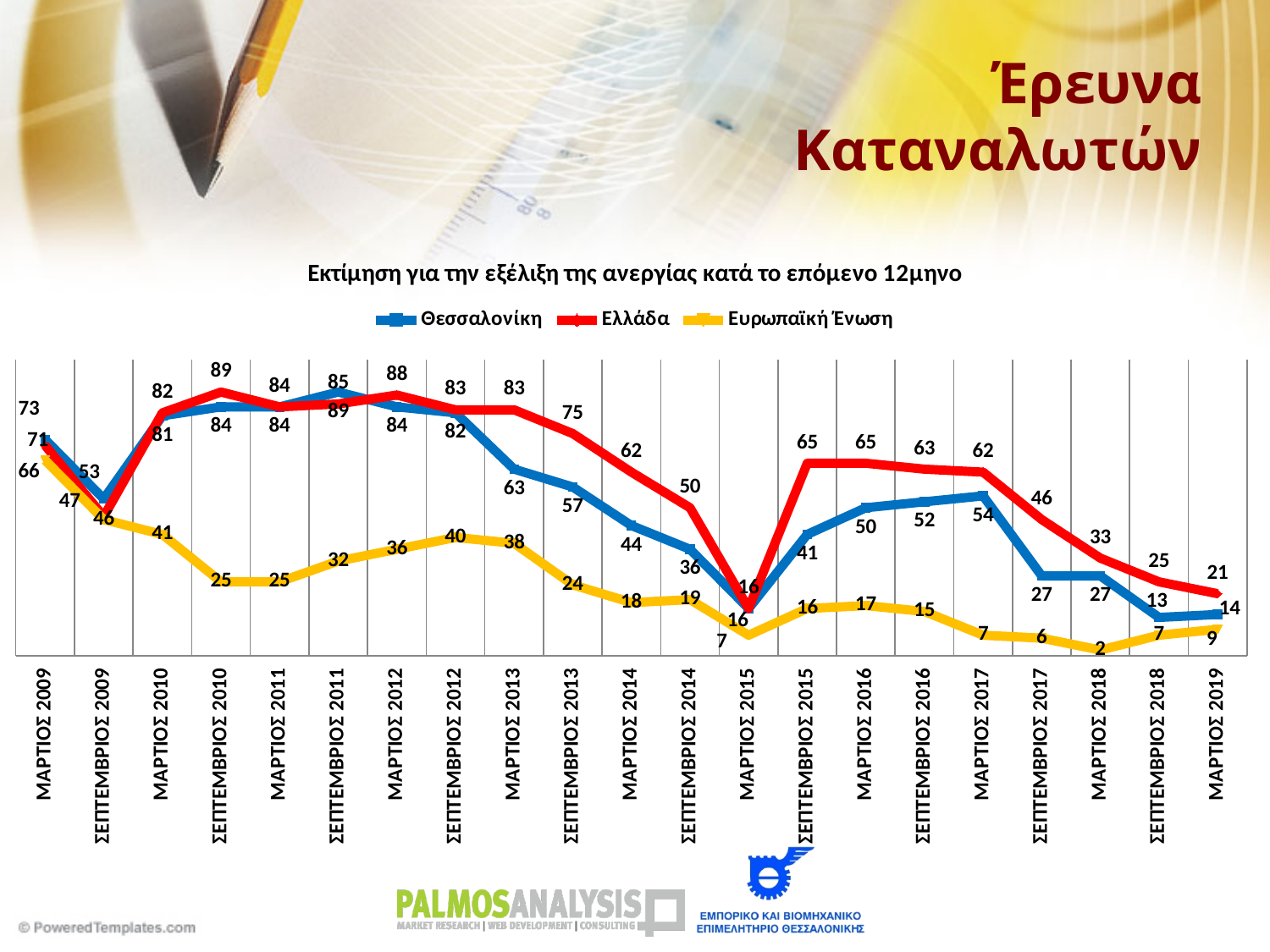
What is the value for Ελλάδα in ΣΕΠΤΕΜΒΡΙΟΣ 2010? 89 In which period does Θεσσαλονίκη reach its highest value? ΣΕΠΤΕΜΒΡΙΟΣ 2011 How many series does the legend list? 3 In which period does Ευρωπαϊκή Ένωση reach its lowest value? ΜΑΡΤΙΟΣ 2018 Does the Ελλάδα series rise or fall from ΣΕΠΤΕΜΒΡΙΟΣ 2015 to ΜΑΡΤΙΟΣ 2019? Fall What is the value for Ευρωπαϊκή Ένωση in ΜΑΡΤΙΟΣ 2018? 2 What is the difference between Ελλάδα and Θεσσαλονίκη in ΜΑΡΤΙΟΣ 2019? 7 What colour is the Ελλάδα line in the legend? Red What kind of chart is shown on the slide? Line chart How many time points are plotted along the x axis? 21 In ΜΑΡΤΙΟΣ 2017, which is larger: Ελλάδα or Θεσσαλονίκη? Ελλάδα What is the value for Θεσσαλονίκη in ΣΕΠΤΕΜΒΡΙΟΣ 2015? 41